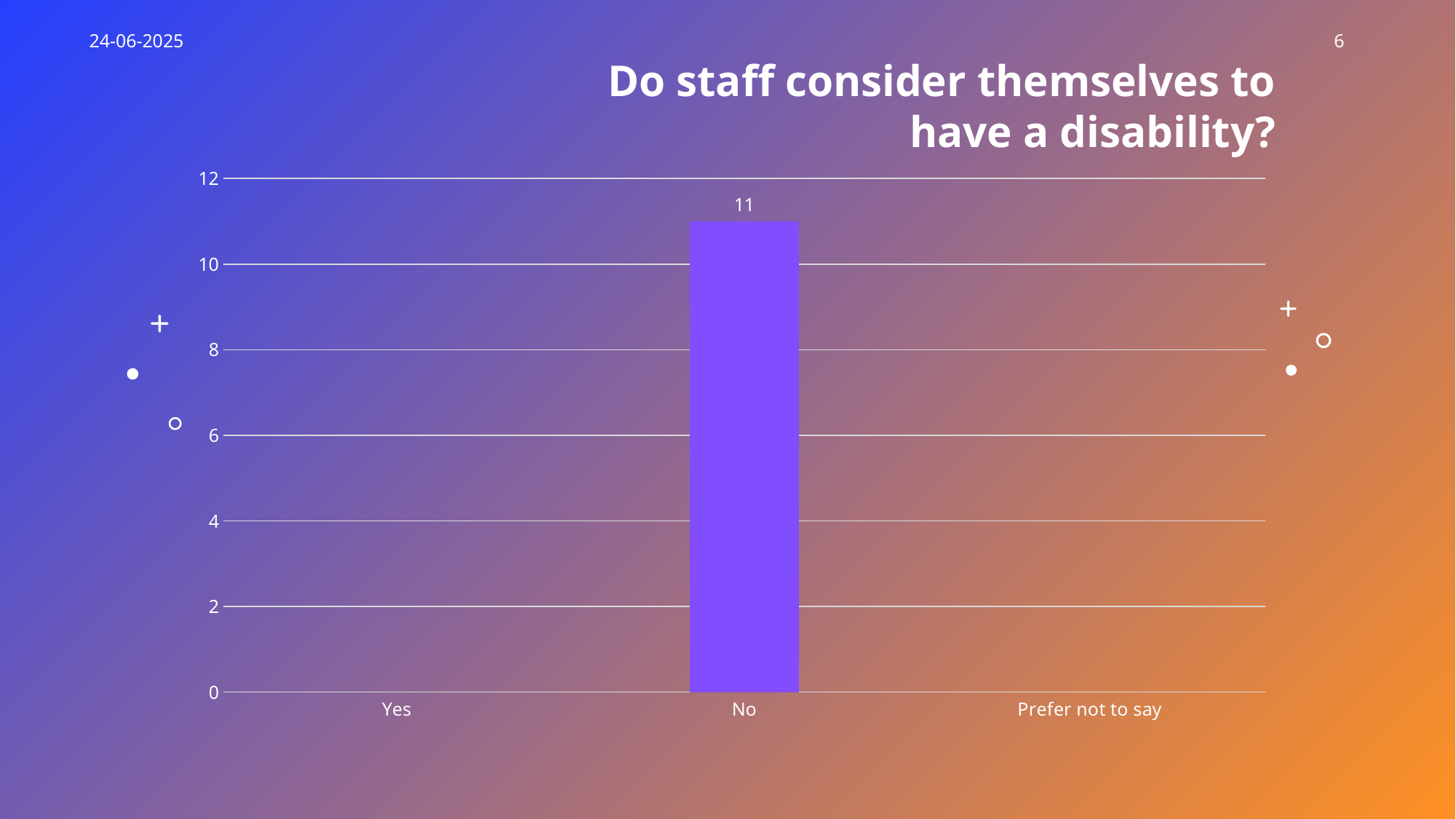
What is the value for "No"? 11 What is the title of the chart? Do staff consider themselves to have a disability? Which is larger, the value for "No" or the value for "Prefer not to say"? No Which is larger, the value for "No" or the value for "Yes"? No What kind of chart is shown on the slide? Bar chart Which category has the highest value? No Is the value for "No" greater or less than 10? greater What is the label of the third category on the x axis? Prefer not to say What is the highest value shown on the y axis? 12 Is the value for "No" greater or less than 12? less How many categories are shown on the x axis? 3